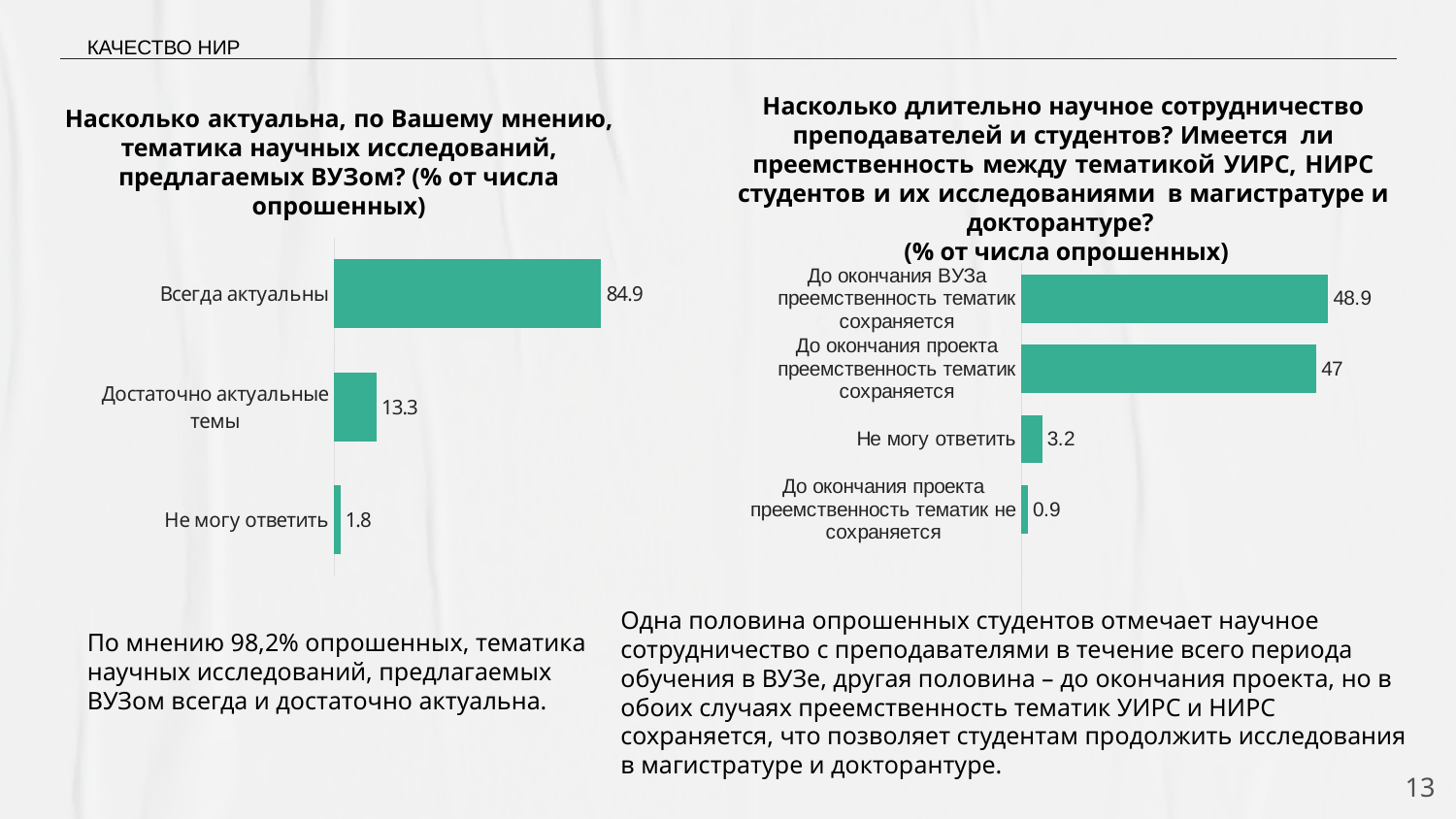
In the left chart, which category has the lowest value? Не могу ответить In the left chart ("Насколько актуальна, по Вашему мнению, тематика научных исследований..."), what is the value for "Всегда актуальны"? 84.9 How many categories does the right chart show? 4 In the right chart, what is the difference between "До окончания проекта преемственность тематик сохраняется" and "Не могу ответить"? 43.8 In the right chart, what is the value for "Не могу ответить"? 3.2 In the left chart, what is the difference between "Всегда актуальны" and "Достаточно актуальные темы"? 71.6 How many categories does the left chart show? 3 What type of chart is the left chart? Bar chart In the left chart, what is the value for "Достаточно актуальные темы"? 13.3 In the right chart, which is larger: "Не могу ответить" or "До окончания проекта преемственность тематик не сохраняется"? Не могу ответить In the right chart, which category has the highest value? До окончания ВУЗа преемственность тематик сохраняется In the right chart ("Насколько длительно научное сотрудничество преподавателей и студентов?..."), what is the value for "До окончания ВУЗа преемственность тематик сохраняется"? 48.9